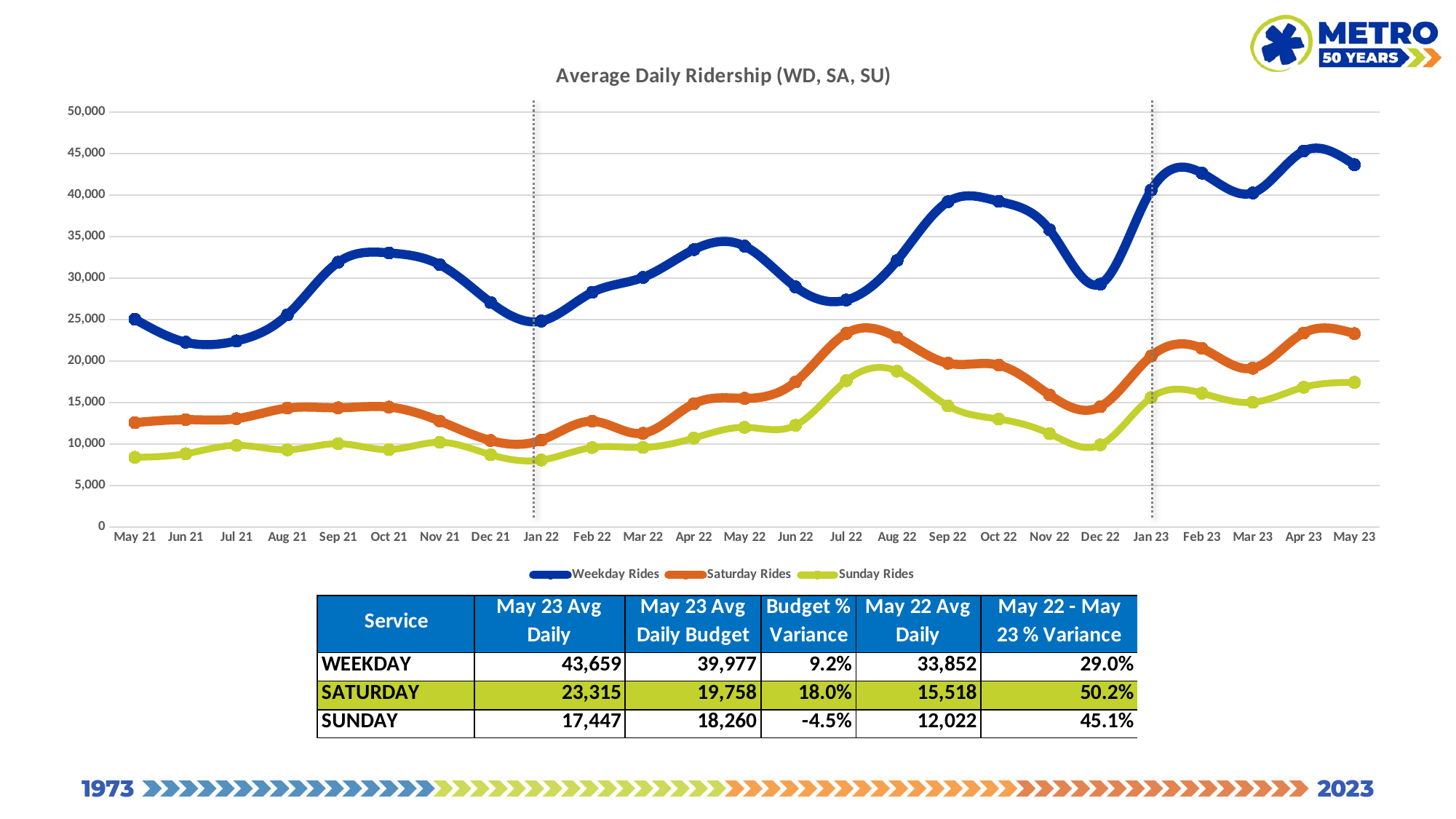
What is the difference between Weekday Rides and Saturday Rides in May 23? 20,344 What is the value of Saturday Rides for May 22? 15,518 Is the value for Sunday Rides in Aug 22 greater or less than 15,000? greater What kind of chart is shown on the slide? line chart Is the value for Weekday Rides in Jan 22 greater or less than 30,000? less What is the title of the chart? Average Daily Ridership (WD, SA, SU) Which is larger: Saturday Rides in Jul 22 or Saturday Rides in Dec 22? Jul 22 How many series does the chart legend list? 3 What is the value of Weekday Rides for May 23? 43,659 How many months are plotted along the x axis of the chart? 25 Which series has the lowest values across the whole chart? Sunday Rides In which month do Weekday Rides reach their highest value? Apr 23